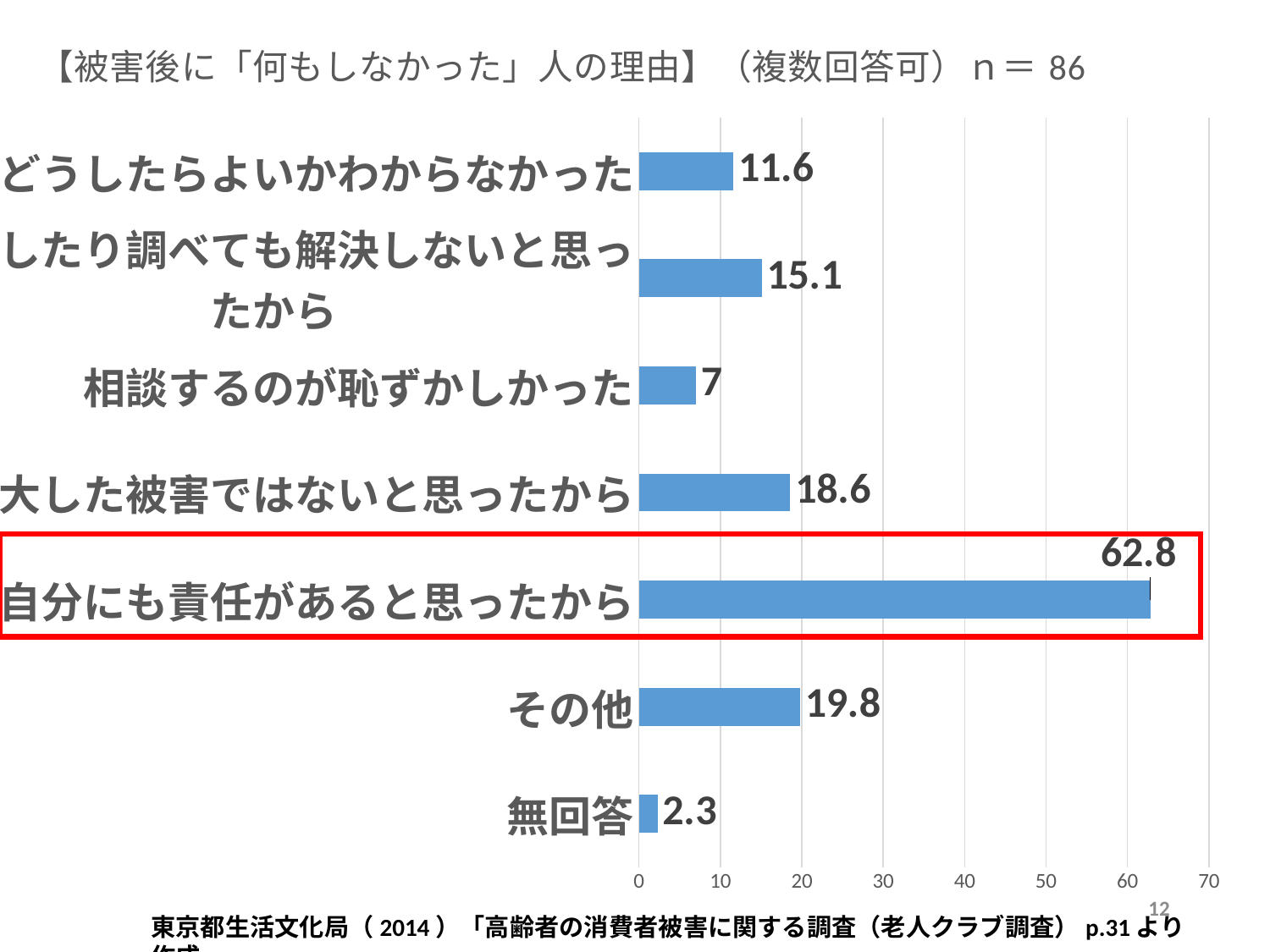
What is the value for どうしたらよいかわからなかった? 11.6 What kind of chart is shown on the slide? bar chart How many categories (bars) does the chart show? 7 What is the value for 相談するのが恥ずかしかった? 7 What is the difference between the values for 自分にも責任があると思ったから and 大した被害ではないと思ったから? 44.2 Which category has the lowest value? 無回答 What is the value for その他? 19.8 Which category has the highest value? 自分にも責任があると思ったから What is the value for 自分にも責任があると思ったから? 62.8 Is the value for 自分にも責任があると思ったから greater or less than 60? greater Which is larger, the value for その他 or the value for 大した被害ではないと思ったから? その他 What is the sample size (n) stated in the chart title? 86